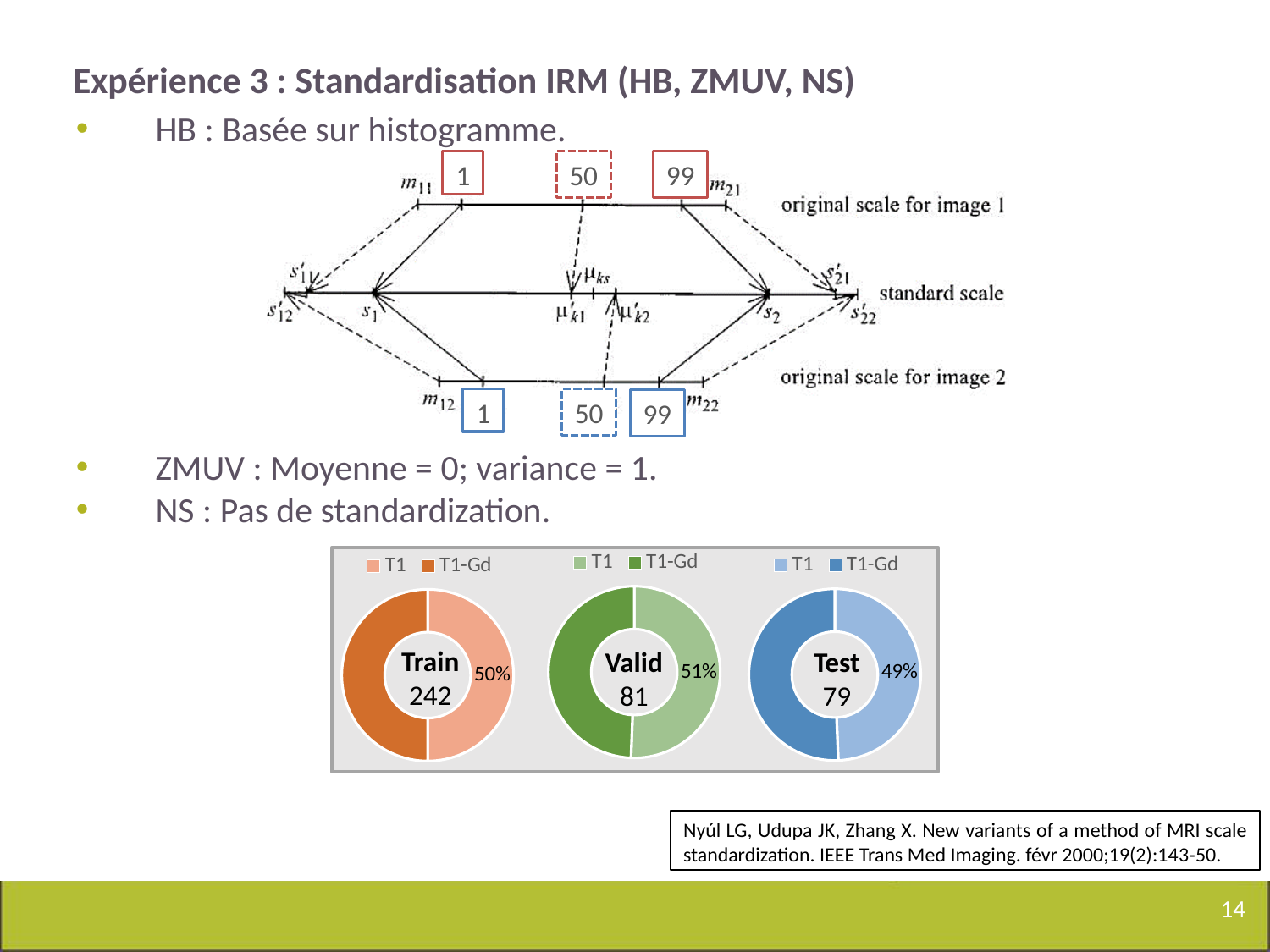
What number is shown in the centre of the Train donut chart? 242 How many series does the legend of each donut chart list? 2 What kind of chart is used for the Train, Valid and Test data at the bottom of the slide? Donut (pie) chart What is the difference between the centre numbers of the Train and Valid donut charts? 161 What are the two legend entries of the Test donut chart? T1 and T1-Gd In the Valid donut chart, what percentage is labelled for the T1 slice? 51% How many donut charts are shown at the bottom of the slide? 3 In the Test donut chart, what percentage is labelled for the T1 slice? 49% What number is shown in the centre of the Valid donut chart? 81 In the Train donut chart, what percentage is labelled for the T1 slice? 50% Which of the three donut charts (Train, Valid, Test) has the largest number in its centre? Train What number is shown in the centre of the Test donut chart? 79